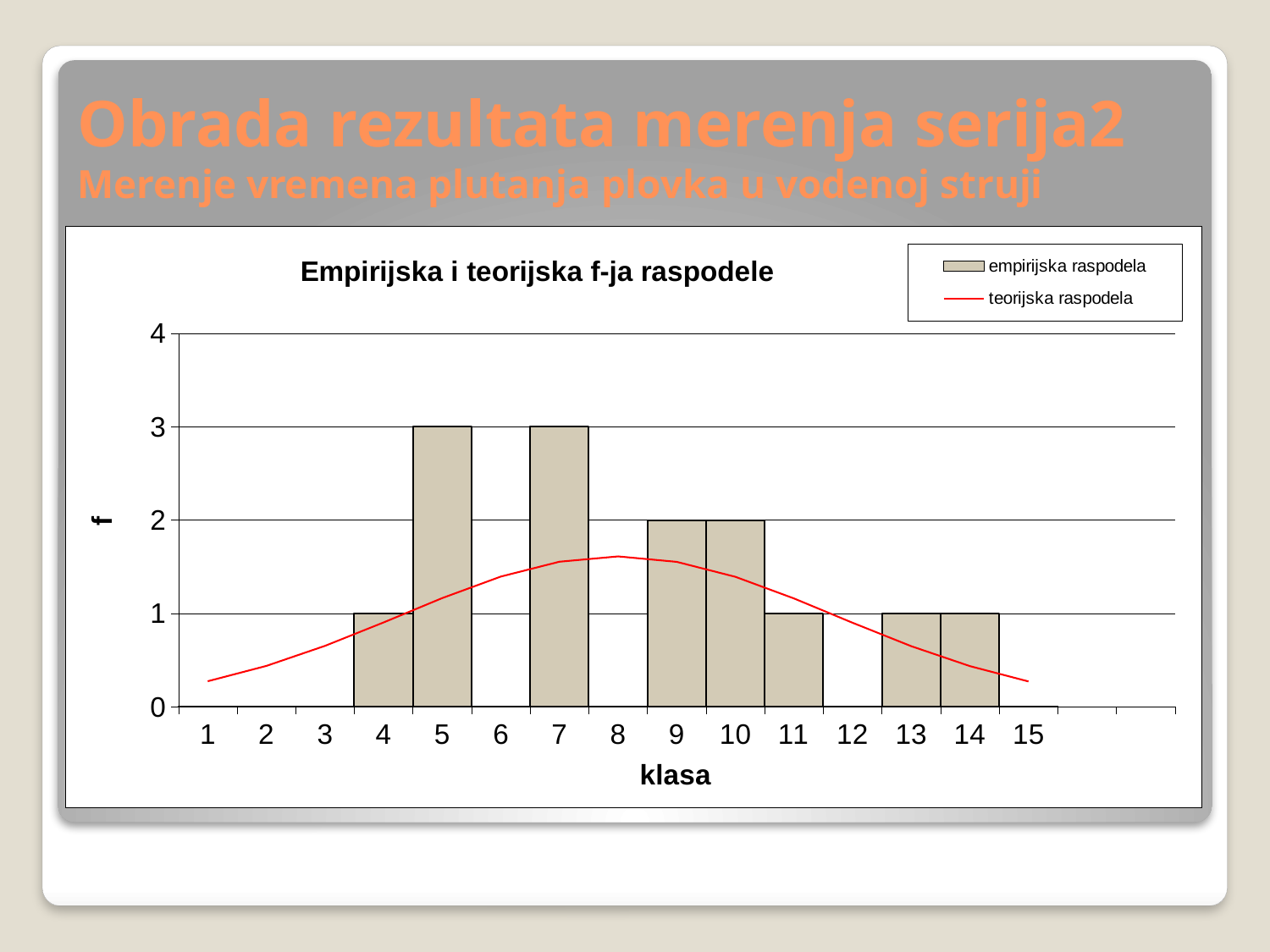
What is the highest value reached by the empirijska raspodela bars? 3 What kind of chart is shown on the slide? A bar chart combined with a line chart What is the value of empirijska raspodela for klasa 5? 3 How many series does the legend list? 2 What is the difference between the empirijska raspodela values for klasa 5 and klasa 4? 2 What is the value of empirijska raspodela for klasa 9? 2 Does the teorijska raspodela line rise or fall from klasa 8 to klasa 15? fall What is the value of empirijska raspodela for klasa 6? 0 Which has a larger empirijska raspodela value, klasa 7 or klasa 10? klasa 7 What is the value of empirijska raspodela for klasa 11? 1 How many klasa categories are labelled on the x axis? 15 Is the value of teorijska raspodela at klasa 8 greater or less than 2? less